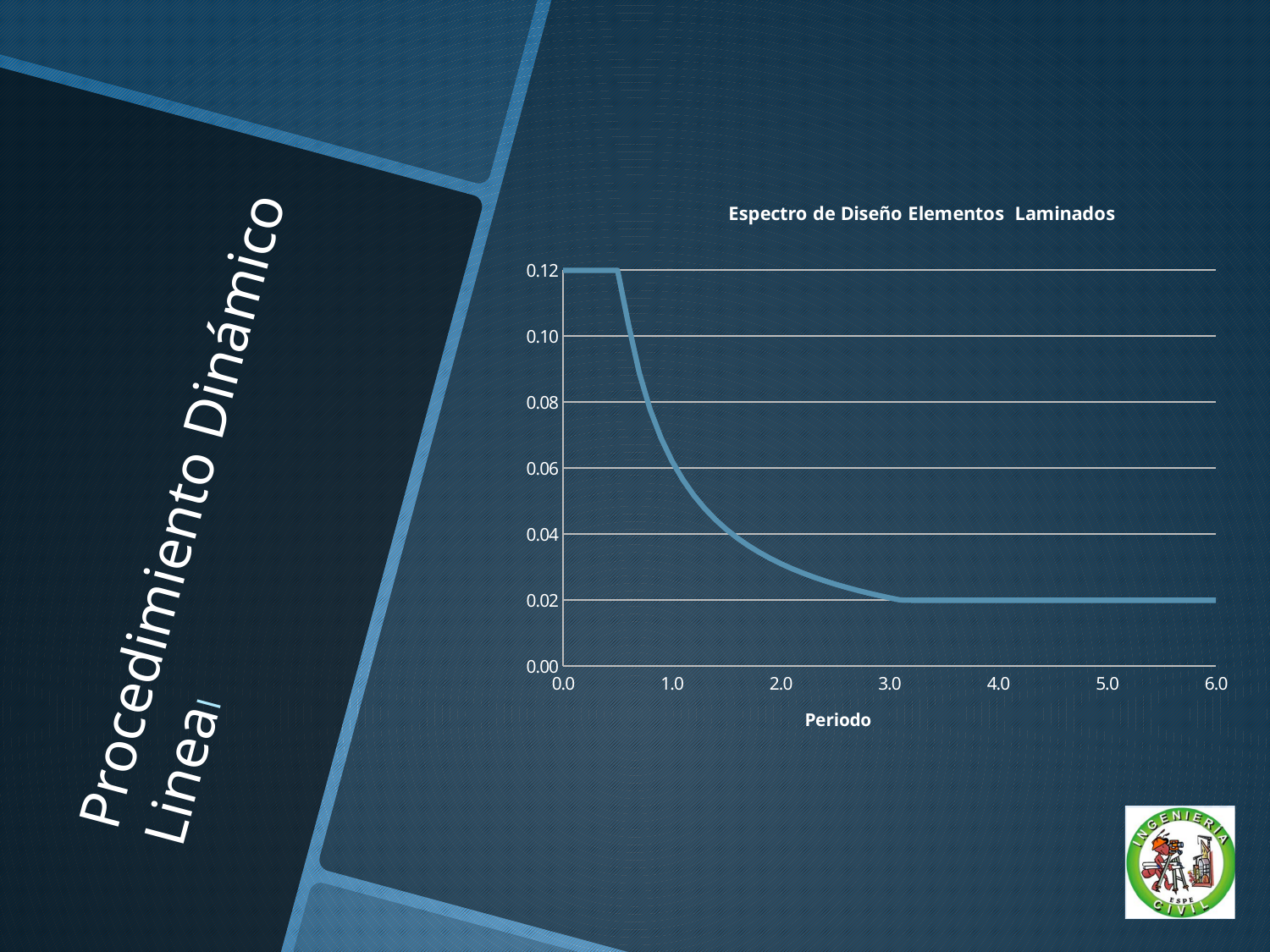
What is the value of the curve at Periodo 0.0? 0.12 What is the label of the x axis? Periodo Does the curve rise or fall as Periodo increases from 0.5 to 3.0? fall Is the value at Periodo 0.0 larger or smaller than the value at Periodo 6.0? larger What is the value of the curve at Periodo 4.0? 0.02 Is the value of the curve at Periodo 2.0 greater or less than 0.02? greater What is the lowest value reached by the curve? 0.02 What is the title of the chart? Espectro de Diseño Elementos Laminados Is the value of the curve at Periodo 2.0 greater or less than 0.04? less What is the highest value reached by the curve? 0.12 What is the value of the curve at Periodo 5.0? 0.02 What kind of chart is shown on the slide? line chart